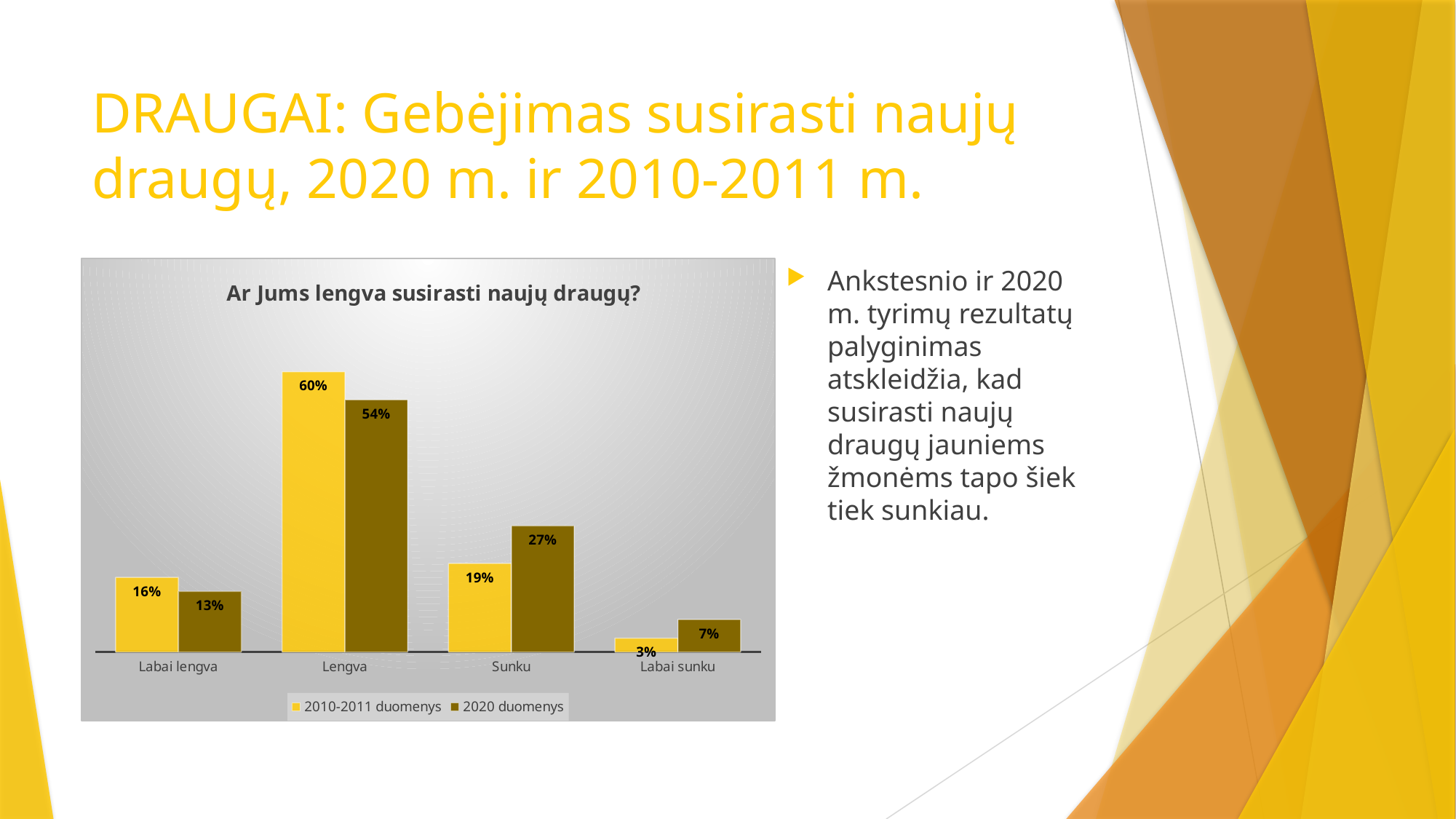
What kind of chart is shown on the slide? Bar chart What is the value for "Labai sunku" in the 2010-2011 duomenys series? 3% Which is larger for "Sunku": the 2010-2011 duomenys value or the 2020 duomenys value? 2020 duomenys Which category has the lowest value in the 2010-2011 duomenys series? Labai sunku What is the difference between the 2010-2011 duomenys and 2020 duomenys values for "Lengva"? 6% How many categories are shown on the x axis? 4 What is the value for "Sunku" in the 2020 duomenys series? 27% What is the value for "Lengva" in the 2010-2011 duomenys series? 60% How many series does the legend list? 2 What is the value for "Labai lengva" in the 2020 duomenys series? 13% Which category has the highest value in the 2020 duomenys series? Lengva What is the title of the chart? Ar Jums lengva susirasti naujų draugų?